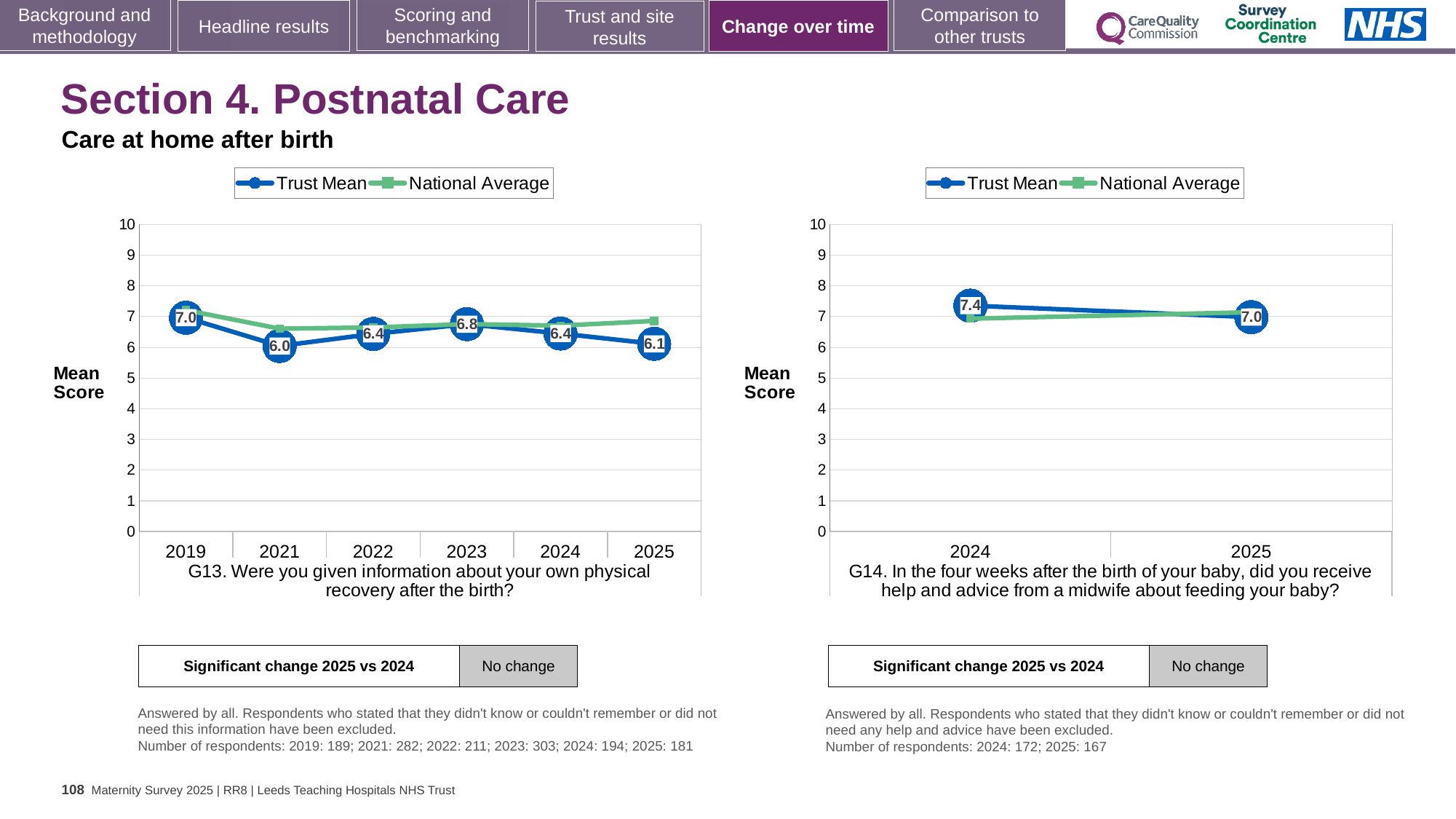
On the left chart (G13), which year has the lowest Trust Mean score? 2021 On the left chart (G13), what is the Trust Mean score for 2025? 6.1 On the right chart (G14), does the Trust Mean rise or fall from 2024 to 2025? fall On the right chart (G14), what is the difference between the Trust Mean scores for 2024 and 2025? 0.4 On the left chart (G13), which year has the highest Trust Mean score? 2019 On the right chart (G14), is the National Average value for 2024 greater or less than 8? less On the left chart (G13), how many years are plotted on the x axis? 6 How many series does the legend of the left chart (G13) list? 2 What kind of chart is the right chart (G14)? line chart On the left chart (G13), what is the Trust Mean score for 2019? 7.0 On the right chart (G14), what is the Trust Mean score for 2024? 7.4 On the left chart (G13), what is the difference between the Trust Mean scores for 2023 and 2021? 0.8